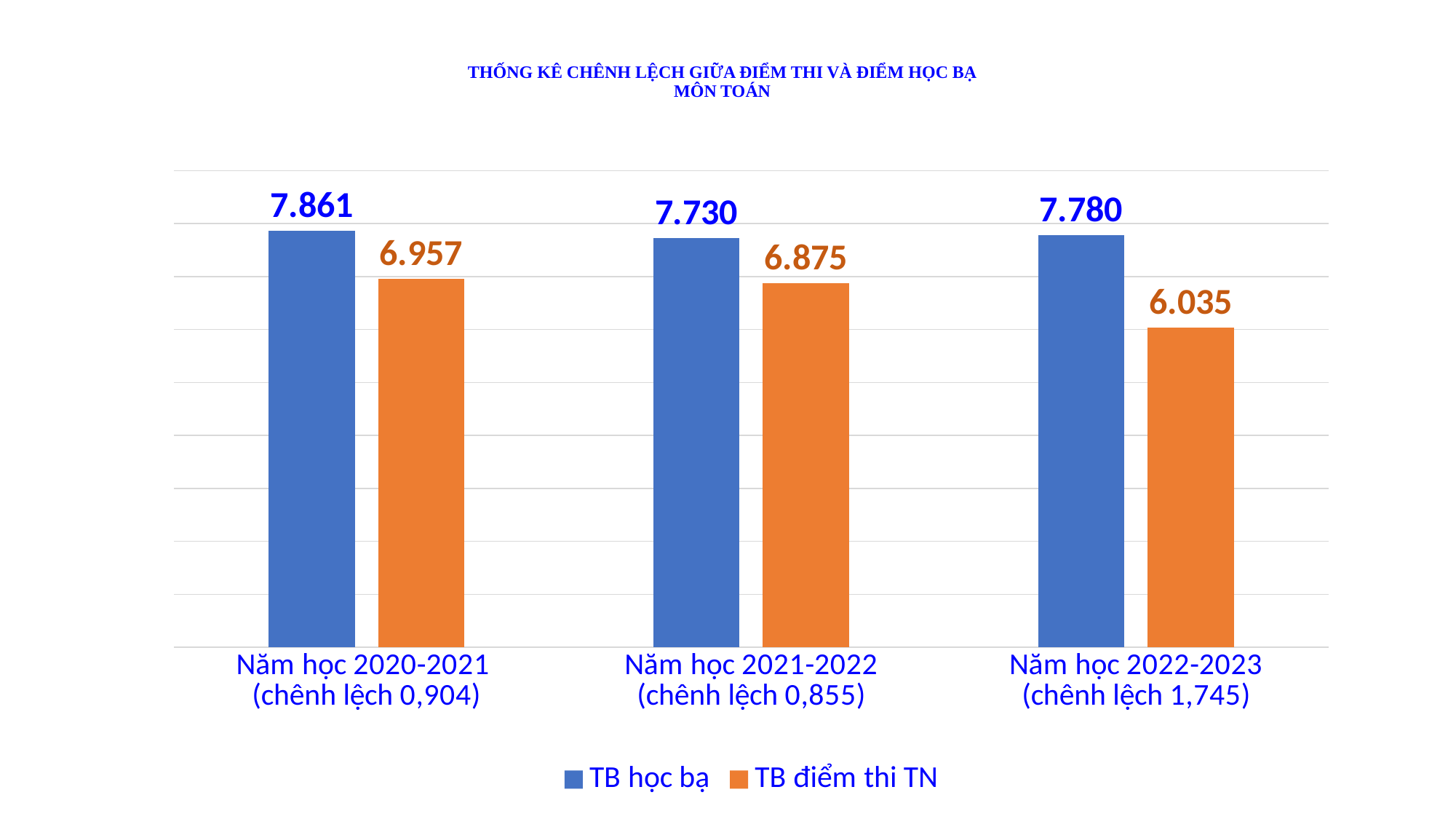
What is the TB điểm thi TN value for Năm học 2021-2022? 6.875 What is the TB điểm thi TN value for Năm học 2022-2023? 6.035 Which is larger for Năm học 2021-2022: TB học bạ or TB điểm thi TN? TB học bạ How many school years are shown on the x axis? 3 What is the difference between TB học bạ and TB điểm thi TN for Năm học 2022-2023? 1.745 Which school year has the lowest TB điểm thi TN value? Năm học 2022-2023 Does the TB điểm thi TN value rise or fall from Năm học 2020-2021 to Năm học 2022-2023? Fall What is the TB học bạ value for Năm học 2020-2021? 7.861 Which school year has the highest TB học bạ value? Năm học 2020-2021 What type of chart is shown on the slide? Bar chart What is the TB học bạ value for Năm học 2021-2022? 7.730 How many series does the legend list? 2